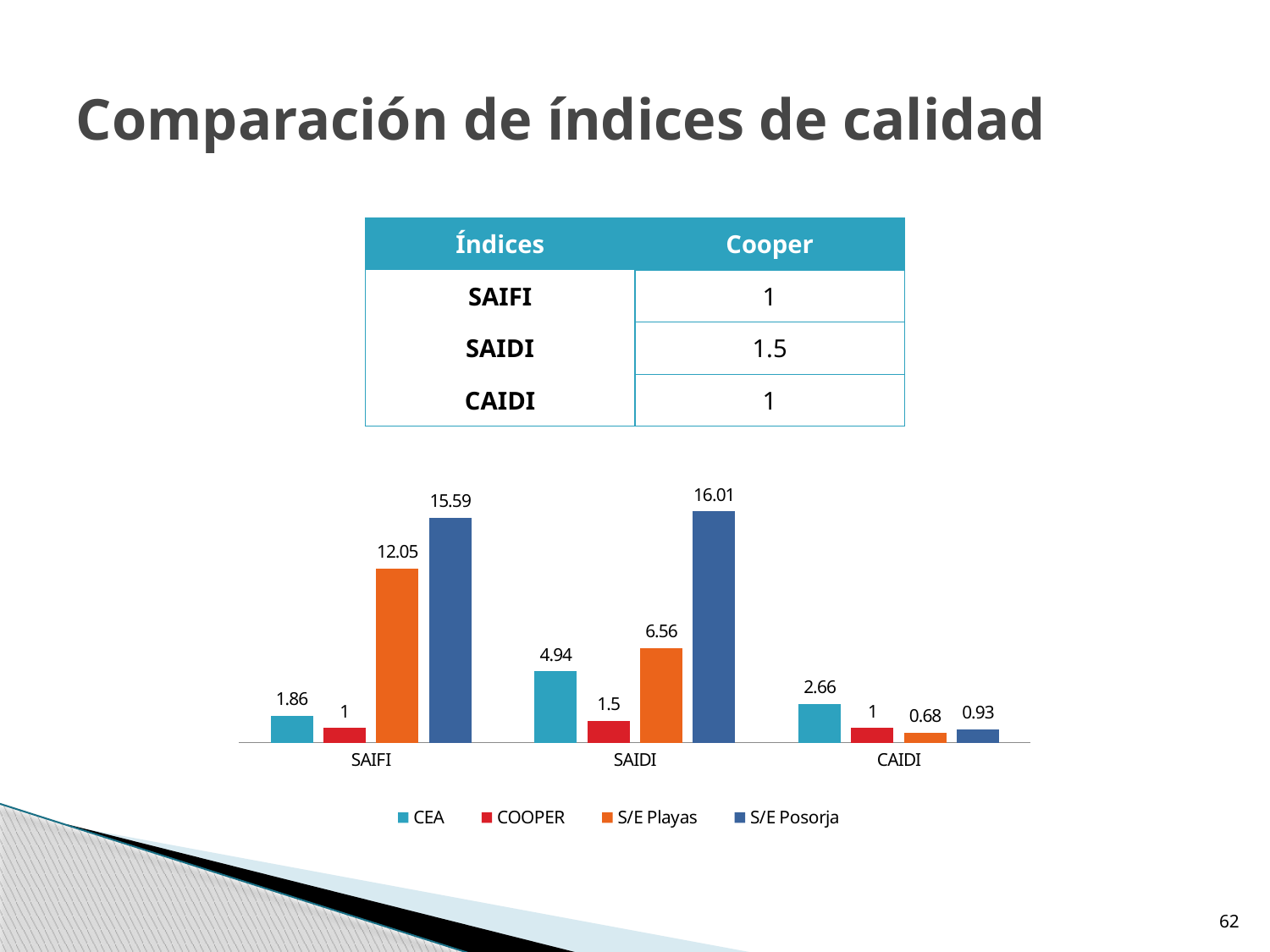
Which series has the lowest value in the CAIDI category? S/E Playas What kind of chart is shown on the slide? Bar chart How many series does the chart legend list? 4 How many categories are shown on the x axis of the chart? 3 Which series has the highest value in the SAIFI category? S/E Posorja What is the value for S/E Posorja in the SAIDI category? 16.01 What colour are the S/E Playas bars in the chart? Orange What is the value for CEA in the CAIDI category? 2.66 What is the value for S/E Playas in the SAIFI category? 12.05 What is the difference between the S/E Posorja and S/E Playas values in the SAIFI category? 3.54 Which is larger: the CEA value for SAIDI or the S/E Playas value for SAIDI? S/E Playas What is the value for COOPER in the SAIDI category? 1.5